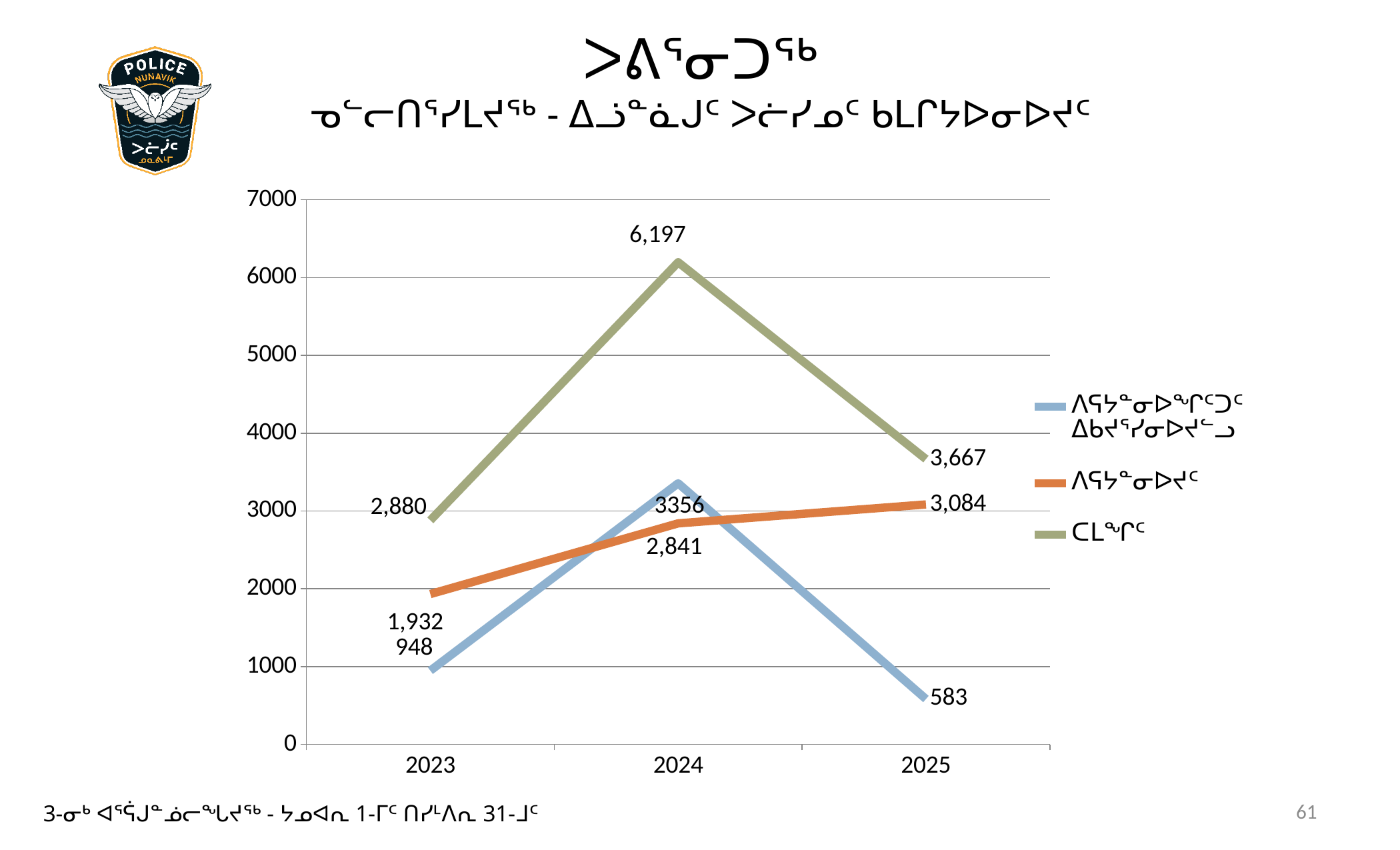
Does the orange line rise or fall from 2023 to 2025? rise What kind of chart is shown on the slide? line chart What is the value of the green line in 2024? 6,197 How many series does the legend list? 3 How many years are plotted along the x axis? 3 Which is larger in 2025, the orange line or the blue line? the orange line What is the difference between the blue line's 2024 value and its 2023 value? 2,408 In which year does the green line reach its highest value? 2024 What is the value of the blue line in 2025? 583 What is the value of the orange line in 2023? 1,932 In which year does the blue line have its lowest value? 2025 What is the difference between the green line's 2024 value and its 2025 value? 2,530